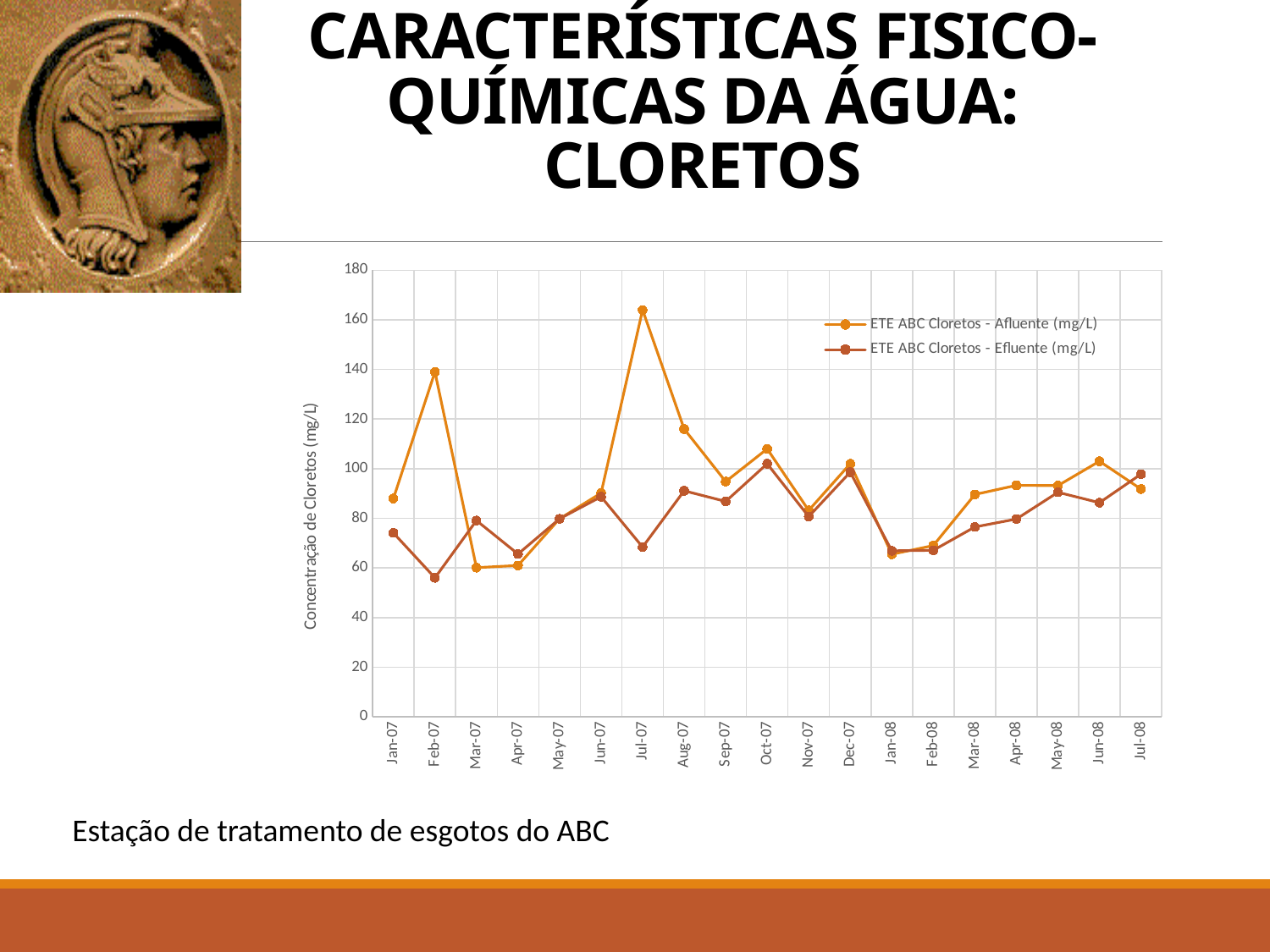
Is the value for ETE ABC Cloretos - Efluente (mg/L) in Jul-07 greater or less than 80? less Does the ETE ABC Cloretos - Afluente (mg/L) series rise or fall from Jul-07 to Sep-07? fall In which month does the ETE ABC Cloretos - Efluente (mg/L) series reach its lowest value? Feb-07 Is the value for ETE ABC Cloretos - Efluente (mg/L) in Feb-07 greater or less than 60? less How many series does the chart legend list? 2 Is the value for ETE ABC Cloretos - Afluente (mg/L) in Jul-07 greater or less than 160? greater What kind of chart is shown on the slide? line chart How many months are plotted along the x axis of the chart? 19 In which month does the ETE ABC Cloretos - Afluente (mg/L) series reach its highest value? Jul-07 In Feb-07, which series has the larger value: ETE ABC Cloretos - Afluente (mg/L) or ETE ABC Cloretos - Efluente (mg/L)? ETE ABC Cloretos - Afluente (mg/L) What is the label on the vertical axis of the chart? Concentração de Cloretos (mg/L)